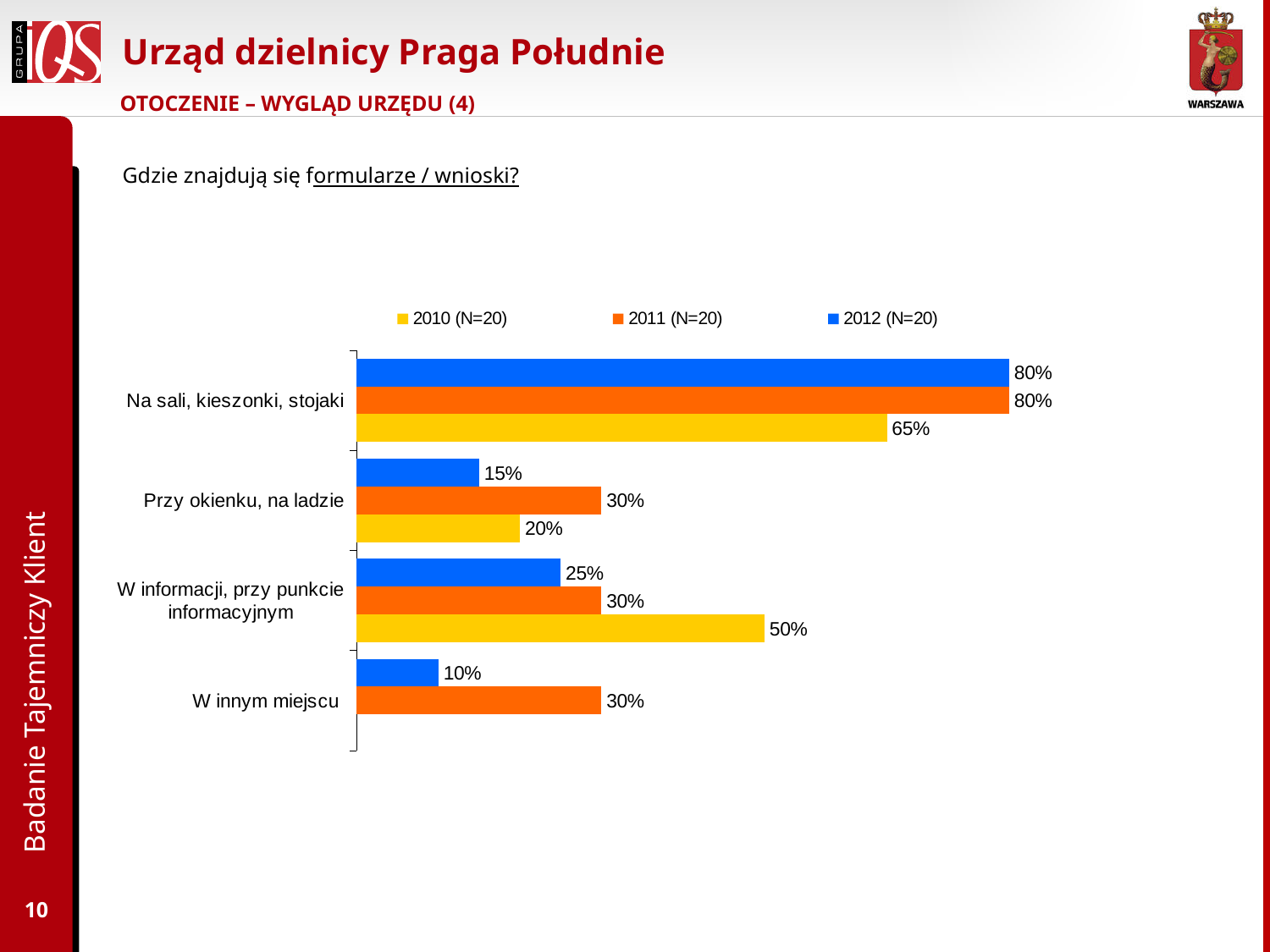
Which is larger for 'Przy okienku, na ladzie': the 2010 (N=20) value or the 2012 (N=20) value? 2010 (N=20) What is the value for 'Na sali, kieszonki, stojaki' in the 2012 (N=20) series? 80% What is the value for 'W informacji, przy punkcie informacyjnym' in the 2010 (N=20) series? 50% What is the difference between the 2010 (N=20) and 2012 (N=20) values for 'W informacji, przy punkcie informacyjnym'? 25% What is the value for 'Przy okienku, na ladzie' in the 2011 (N=20) series? 30% What question does the chart answer, as stated above it? Gdzie znajdują się formularze / wnioski? What kind of chart is shown on the slide? Bar chart Which category has the highest value in the 2010 (N=20) series? Na sali, kieszonki, stojaki Which category has the lowest value in the 2012 (N=20) series? W innym miejscu What is the value for 'W innym miejscu' in the 2012 (N=20) series? 10% How many series does the legend list? 3 How many categories are shown on the chart? 4